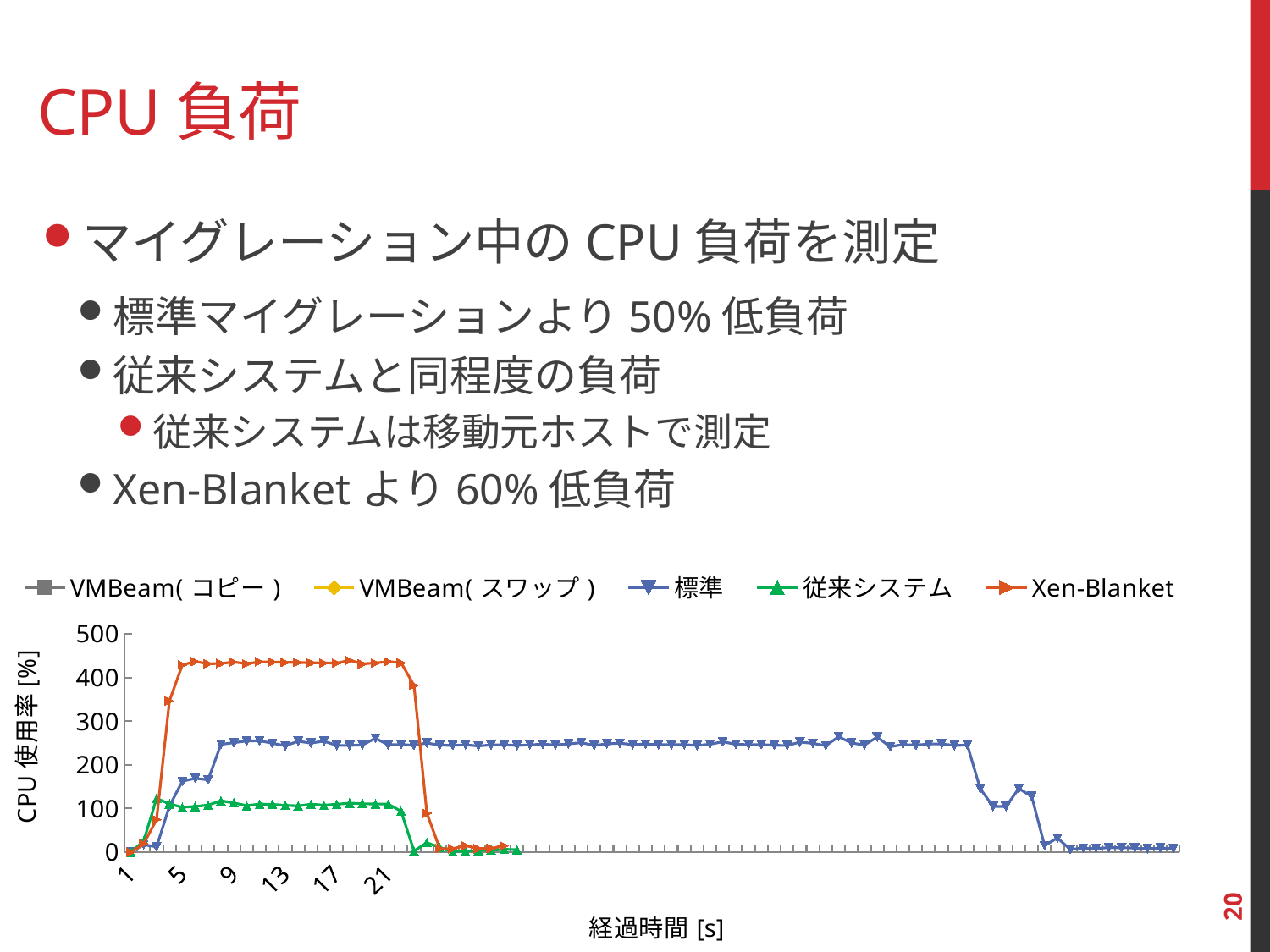
What kind of chart is shown on the slide? line chart Is the plateau value of the 標準 series between about 9 s and 60 s greater or less than 200? greater What is the label of the x axis? 経過時間 [s] What is the label of the y axis? CPU 使用率 [%] Is the peak value of the Xen-Blanket series greater or less than 400? greater Which series has the higher plateau value, Xen-Blanket or 従来システム? Xen-Blanket How many series does the chart legend list? 5 Is the plateau value of the 従来システム series greater or less than 200? less What is the maximum value shown on the y axis? 500 Which series reaches the highest CPU usage in the chart? Xen-Blanket Which series stays at a high CPU usage for the longest time, 標準 or Xen-Blanket? 標準